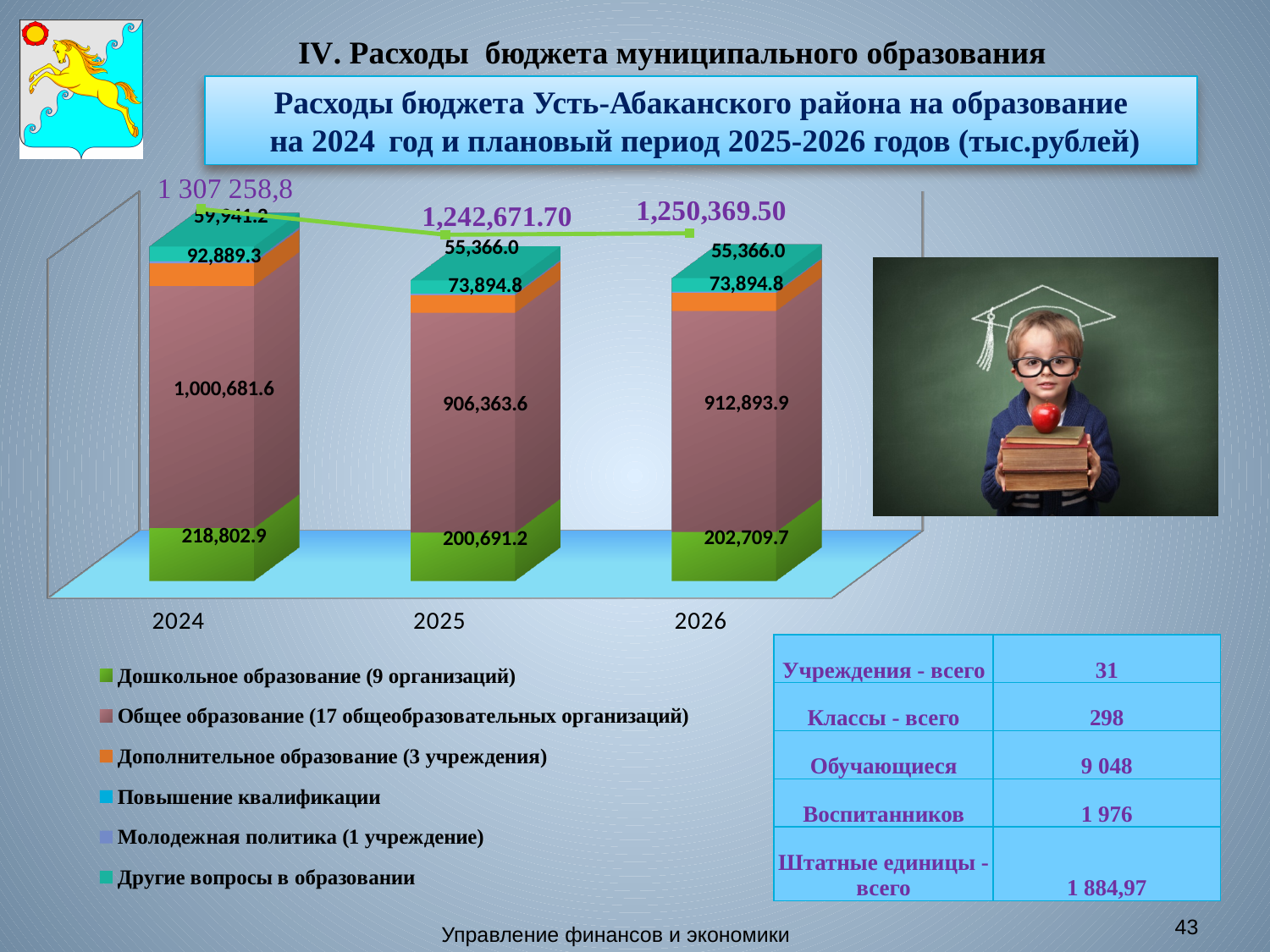
What is the difference between the Дошкольное образование values for 2024 and 2025? 18,111.7 Which year has the highest total education expenditure? 2024 How many years are shown on the x axis of the chart? 3 What is the value for Дошкольное образование in 2024? 218,802.9 Which year has the lowest total education expenditure? 2025 What is the total education expenditure shown for 2026? 1,250,369.50 What is the value for Общее образование in 2026? 912,893.9 Which is larger: the value for Дошкольное образование in 2025 or in 2026? 2026 What is the difference between the Общее образование values for 2026 and 2025? 6,530.3 What is the value for Общее образование in 2025? 906,363.6 How many series does the chart legend list? 6 What is the total education expenditure shown for 2025? 1,242,671.70